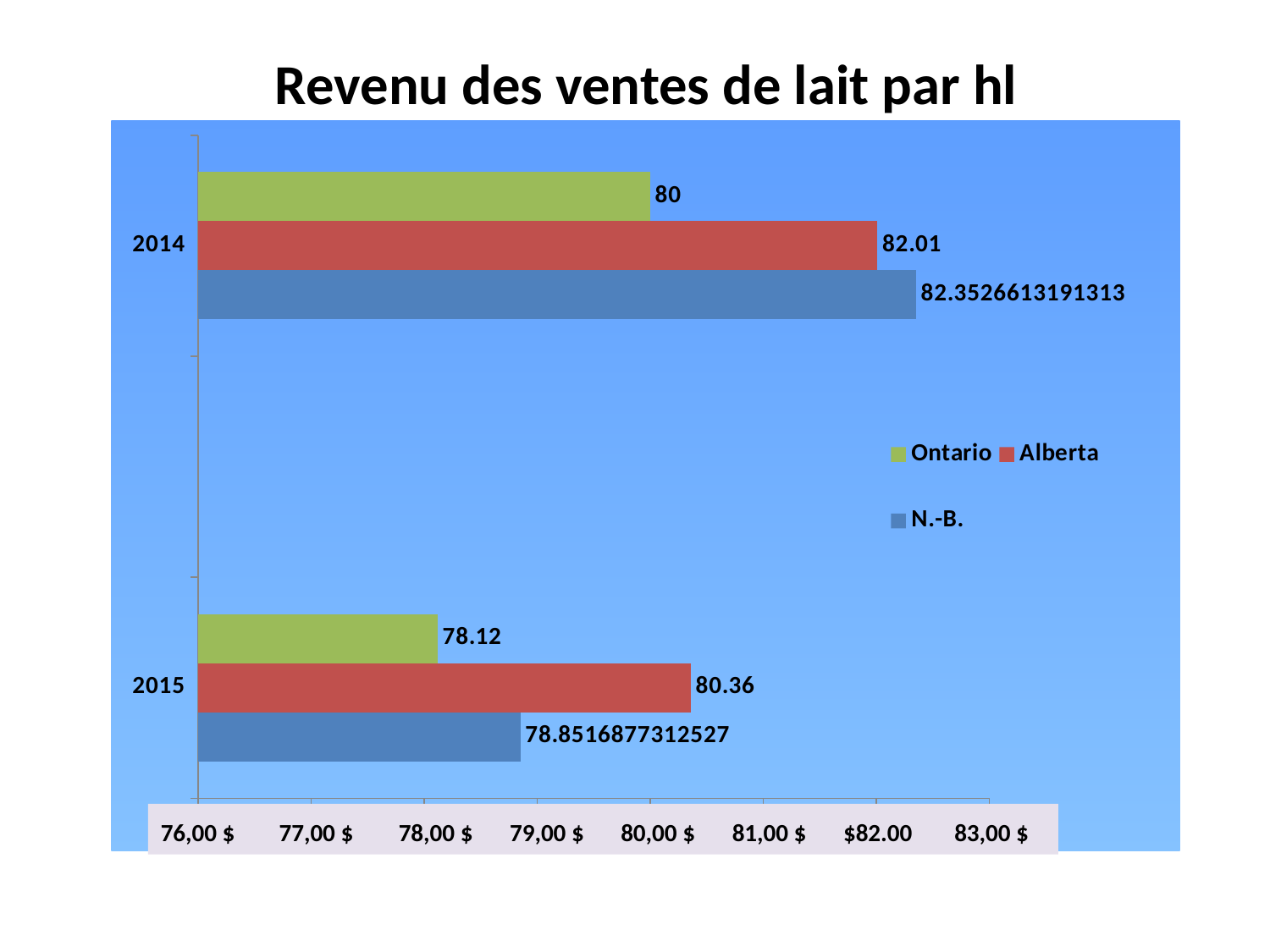
What is the value for Ontario in 2014? 80 Which is larger, the Ontario value in 2014 or the Ontario value in 2015? 2014 What is the value for Alberta in 2015? 80.36 What is the title of the chart? Revenu des ventes de lait par hl What is the value for Ontario in 2015? 78.12 What is the difference between the Alberta value in 2014 and the Alberta value in 2015? 1.65 Which series has the lowest value in 2014? Ontario What is the value for N.-B. in 2014? 82.3526613191313 Which series has the highest value in 2015? Alberta How many year categories are shown on the chart? 2 What type of chart is shown on the slide? bar chart How many series does the legend list? 3